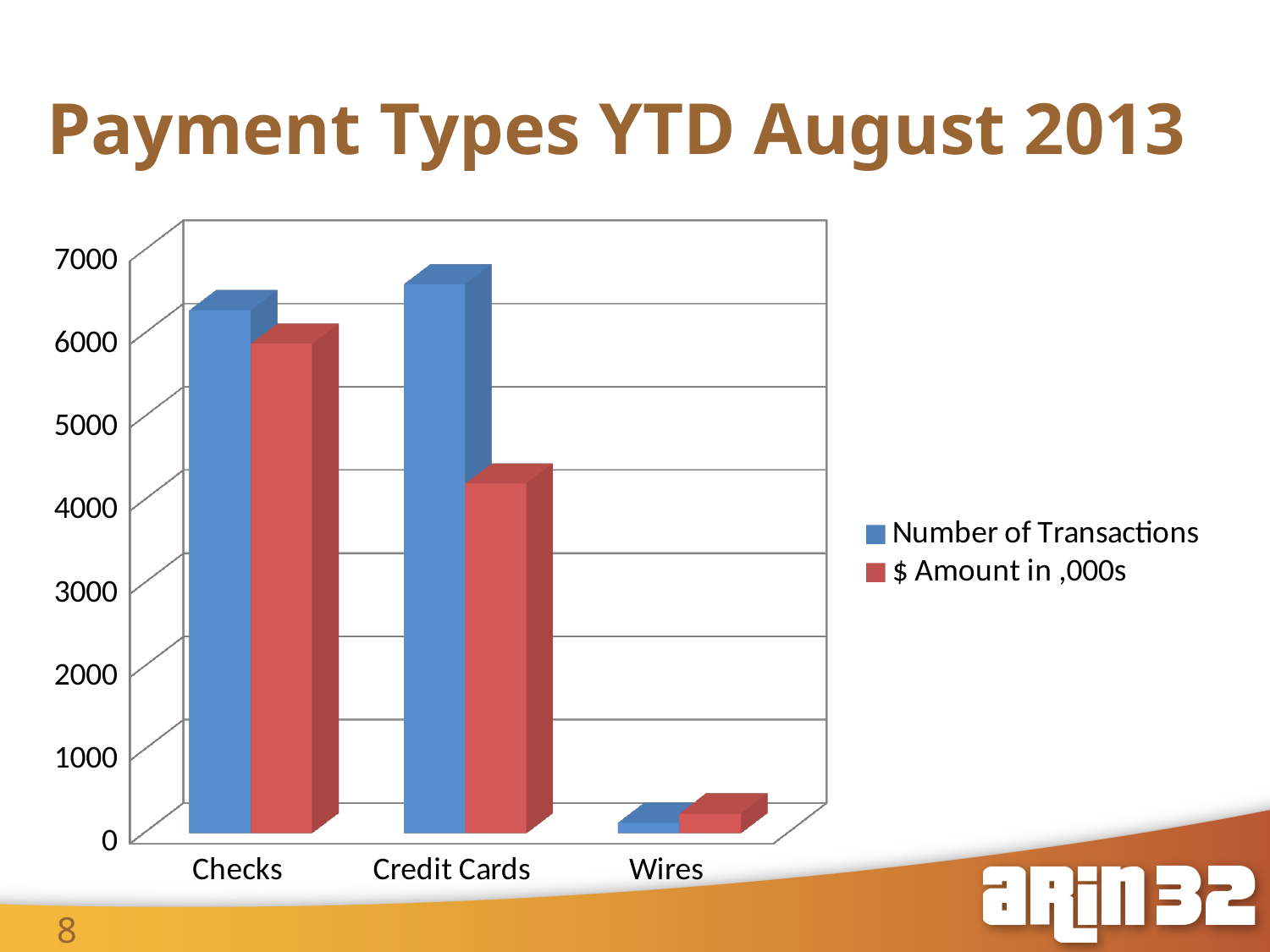
Which payment type has the highest Number of Transactions? Credit Cards Is the Number of Transactions for Wires greater or less than 1000? less Which payment type has the highest $ Amount in ,000s? Checks What kind of chart is shown on the slide? Bar chart Is the $ Amount in ,000s for Credit Cards greater or less than 5000? less What is the title of the chart? Payment Types YTD August 2013 Is the Number of Transactions for Credit Cards greater or less than 6000? greater How many series does the legend list? 2 Which payment type has the lowest Number of Transactions? Wires For Credit Cards, which is larger: the Number of Transactions or the $ Amount in ,000s? Number of Transactions How many payment type categories are shown on the x axis? 3 Do the $ Amount in ,000s values rise or fall moving from Checks to Wires along the x axis? fall